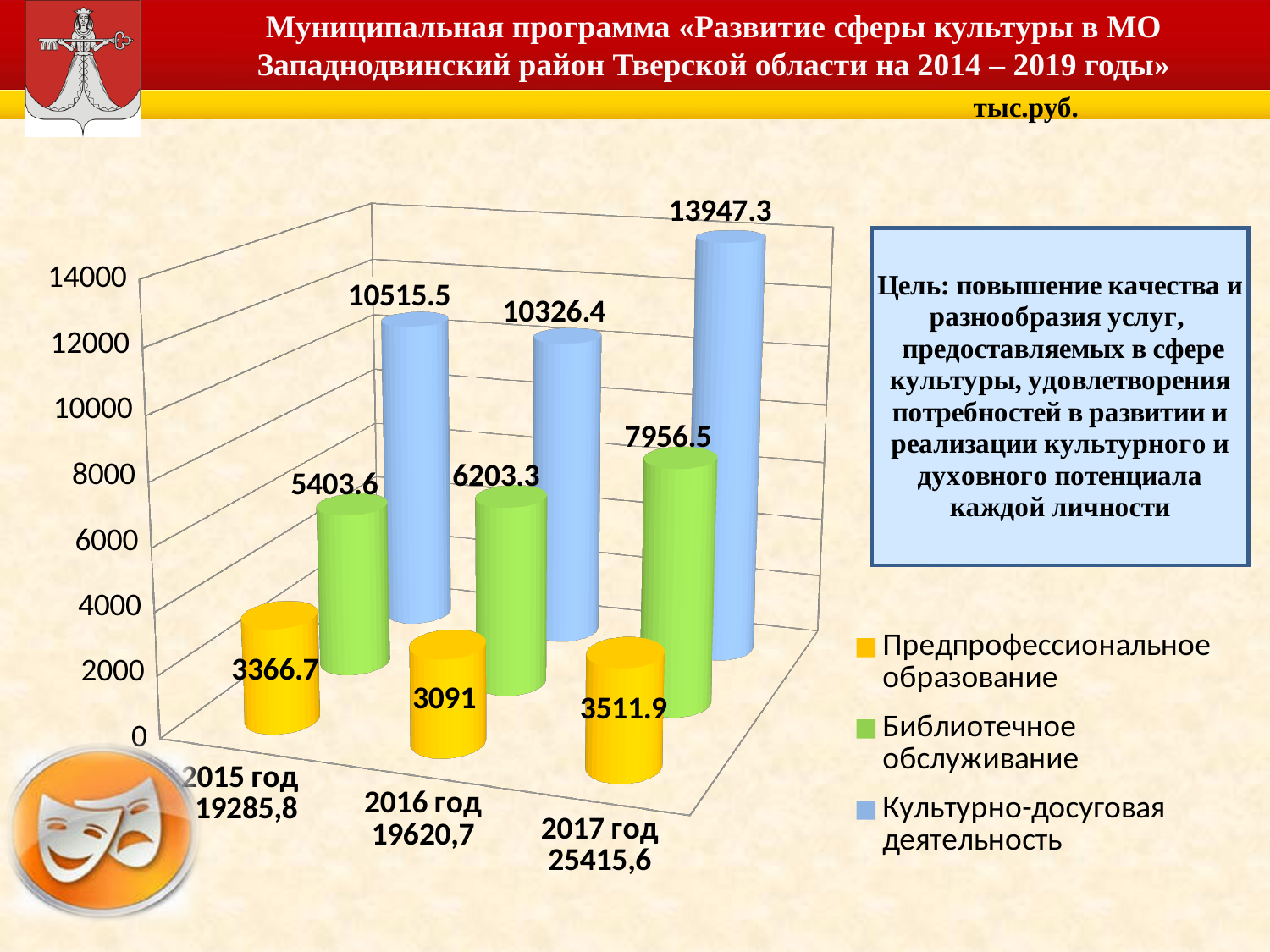
Is the value for Культурно-досуговая деятельность in 2015 год greater or less than 10000? greater Which is larger: Библиотечное обслуживание in 2015 год or Предпрофессиональное образование in 2017 год? Библиотечное обслуживание in 2015 год What is the difference between the Культурно-досуговая деятельность values for 2017 год and 2016 год? 3620.9 How many series does the legend list? 3 In which year is the value for Предпрофессиональное образование the lowest? 2016 год What is the value for Предпрофессиональное образование in 2015 год? 3366.7 What is the value for Библиотечное обслуживание in 2016 год? 6203.3 What kind of chart is shown on the slide? bar chart In which year is the value for Библиотечное обслуживание the highest? 2017 год Does the value for Библиотечное обслуживание rise or fall from 2015 год to 2017 год? rise How many years are shown on the x axis of the chart? 3 What is the value for Культурно-досуговая деятельность in 2017 год? 13947.3